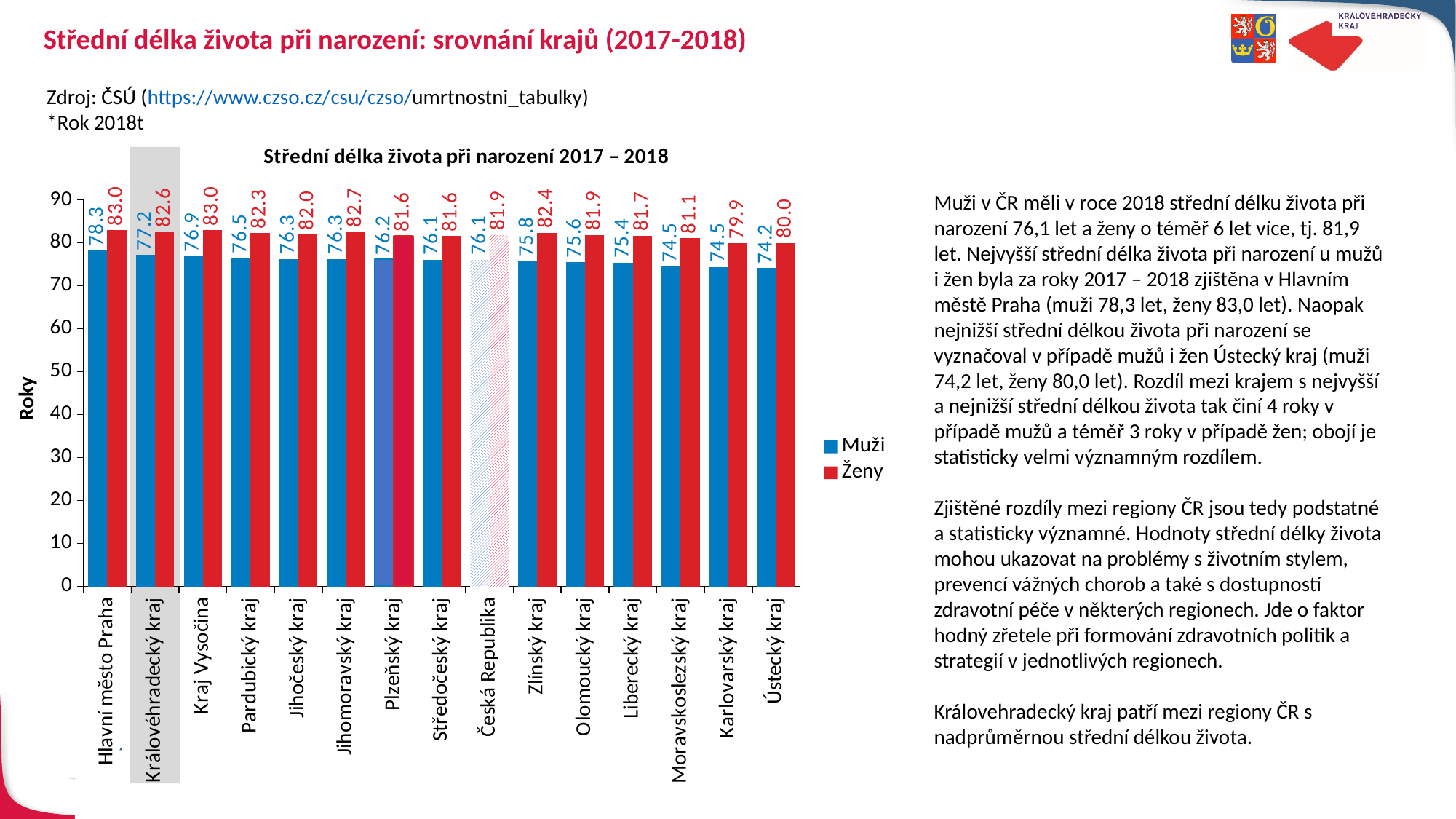
How many series does the legend list? 2 What is the difference between the Muži values for Hlavní město Praha and Ústecký kraj? 4.1 Which category has the highest value for Muži? Hlavní město Praha How many categories are shown on the x axis? 15 What is the value for Ženy in Ústecký kraj? 80.0 What is the value for Muži in Královéhradecký kraj? 77.2 Which category has the lowest value for Ženy? Karlovarský kraj What is the value for Ženy in Česká Republika? 81.9 What kind of chart is shown? bar chart What is the label of the y axis? Roky Which is larger, the Ženy value for Jihomoravský kraj or for Jihočeský kraj? Jihomoravský kraj What is the title of the chart? Střední délka života při narození 2017 – 2018